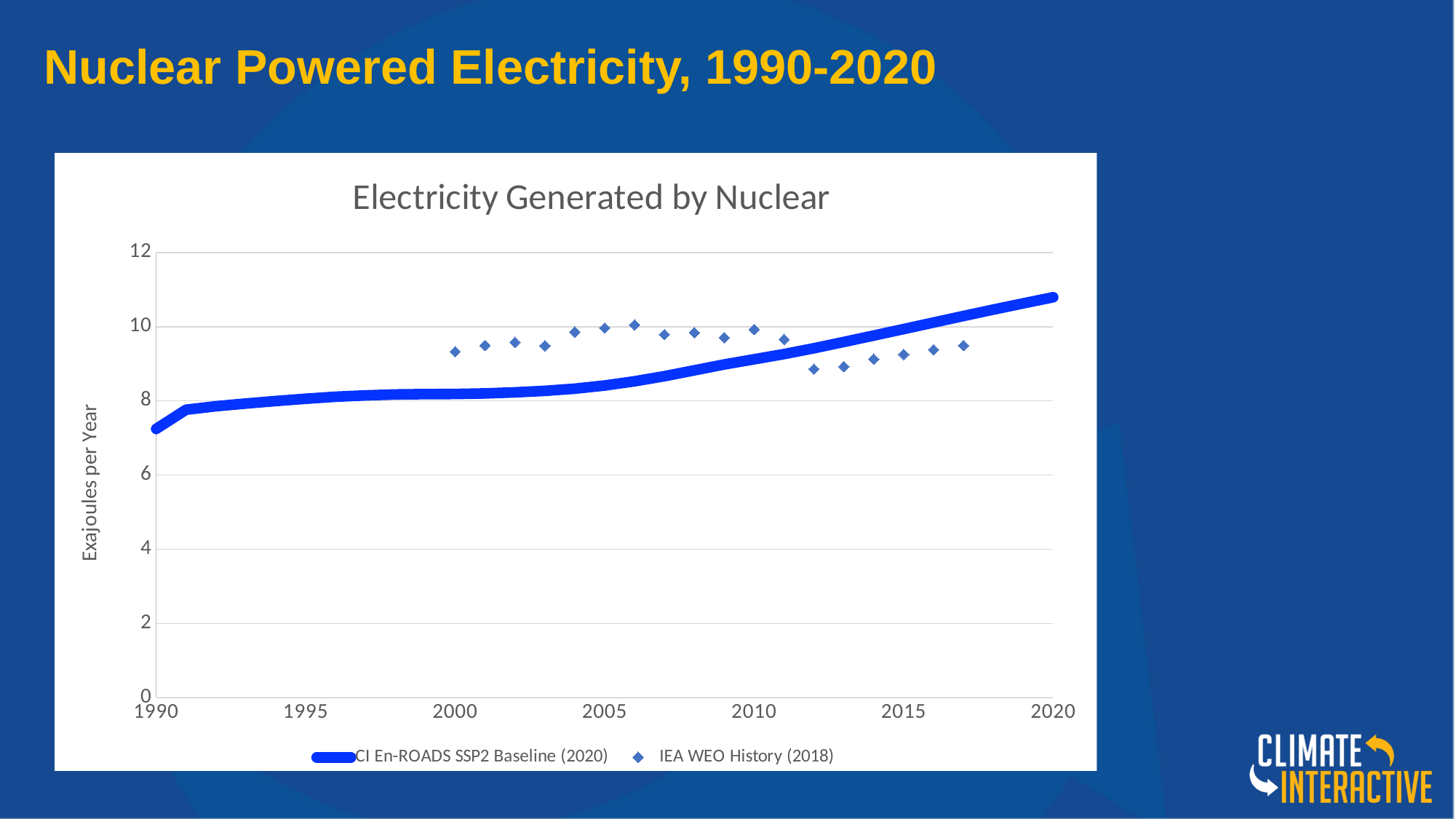
Is the IEA WEO History (2018) value in 2000 greater or less than 8? greater Does the CI En-ROADS SSP2 Baseline (2020) series rise or fall from 1990 to 2020? rise What kind of chart is shown on the slide? line chart Is the value of the CI En-ROADS SSP2 Baseline (2020) series in 2020 greater or less than 10? greater How many series does the chart legend list? 2 In 2005, which series has the higher value: CI En-ROADS SSP2 Baseline (2020) or IEA WEO History (2018)? IEA WEO History (2018) What is the title of the chart? Electricity Generated by Nuclear What is the label on the vertical axis of the chart? Exajoules per Year In which year does the CI En-ROADS SSP2 Baseline (2020) series have its lowest value? 1990 Is the value of the CI En-ROADS SSP2 Baseline (2020) series in 1990 greater or less than 8? less In which year does the CI En-ROADS SSP2 Baseline (2020) series reach its highest value? 2020